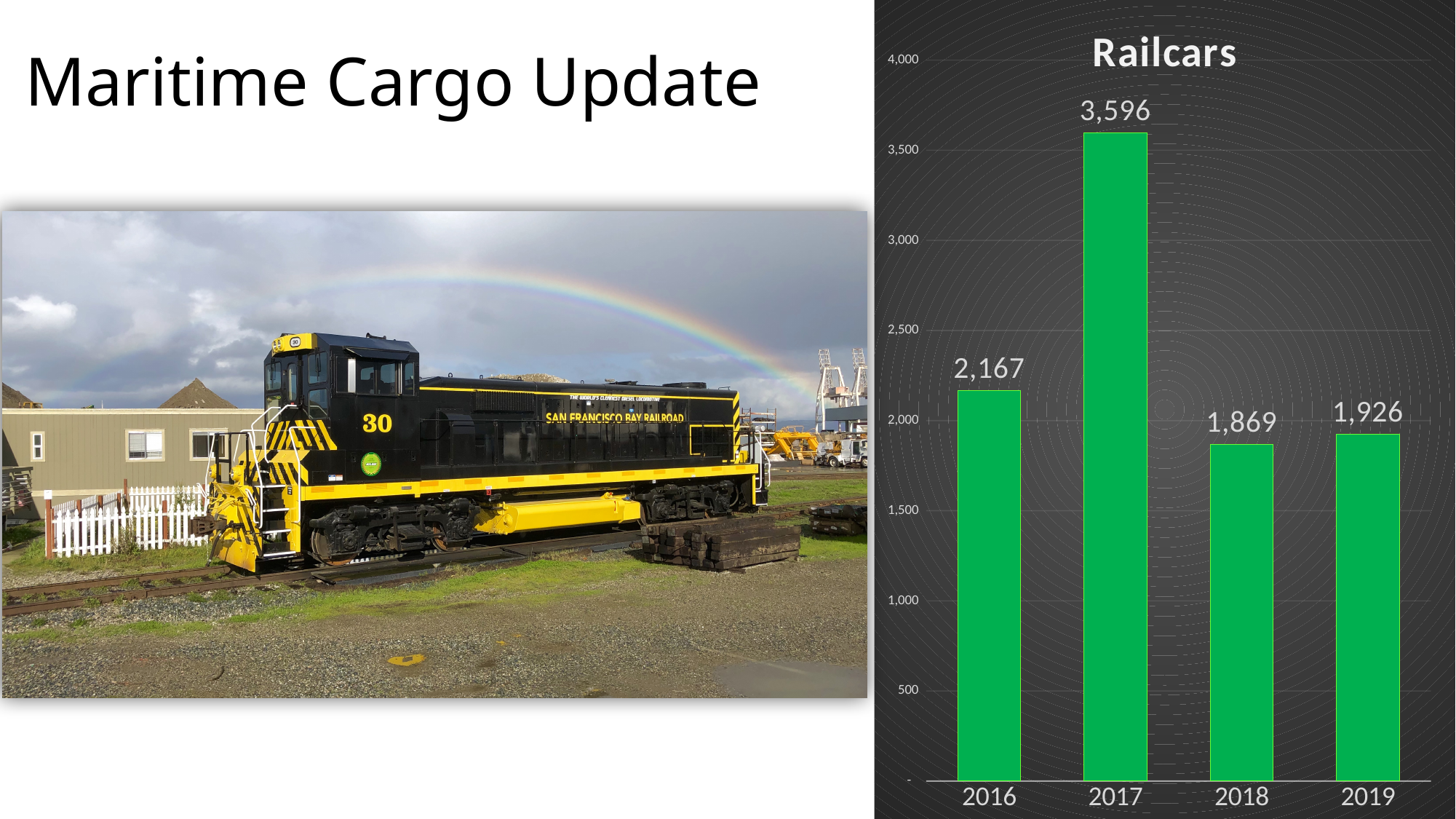
What is the value for 2016 in the Railcars chart? 2,167 Which is larger, the value for 2016 or the value for 2019? 2016 Which year has the highest number of railcars? 2017 What is the difference between the 2019 and 2018 railcar values? 57 Which year has the lowest number of railcars? 2018 What is the value for 2019 in the Railcars chart? 1,926 What is the difference between the 2017 and 2016 railcar values? 1,429 What is the title of the chart on the slide? Railcars What is the value for 2018 in the Railcars chart? 1,869 What is the value for 2017 in the Railcars chart? 3,596 How many years are shown in the Railcars chart? 4 What kind of chart is the Railcars chart? Bar chart